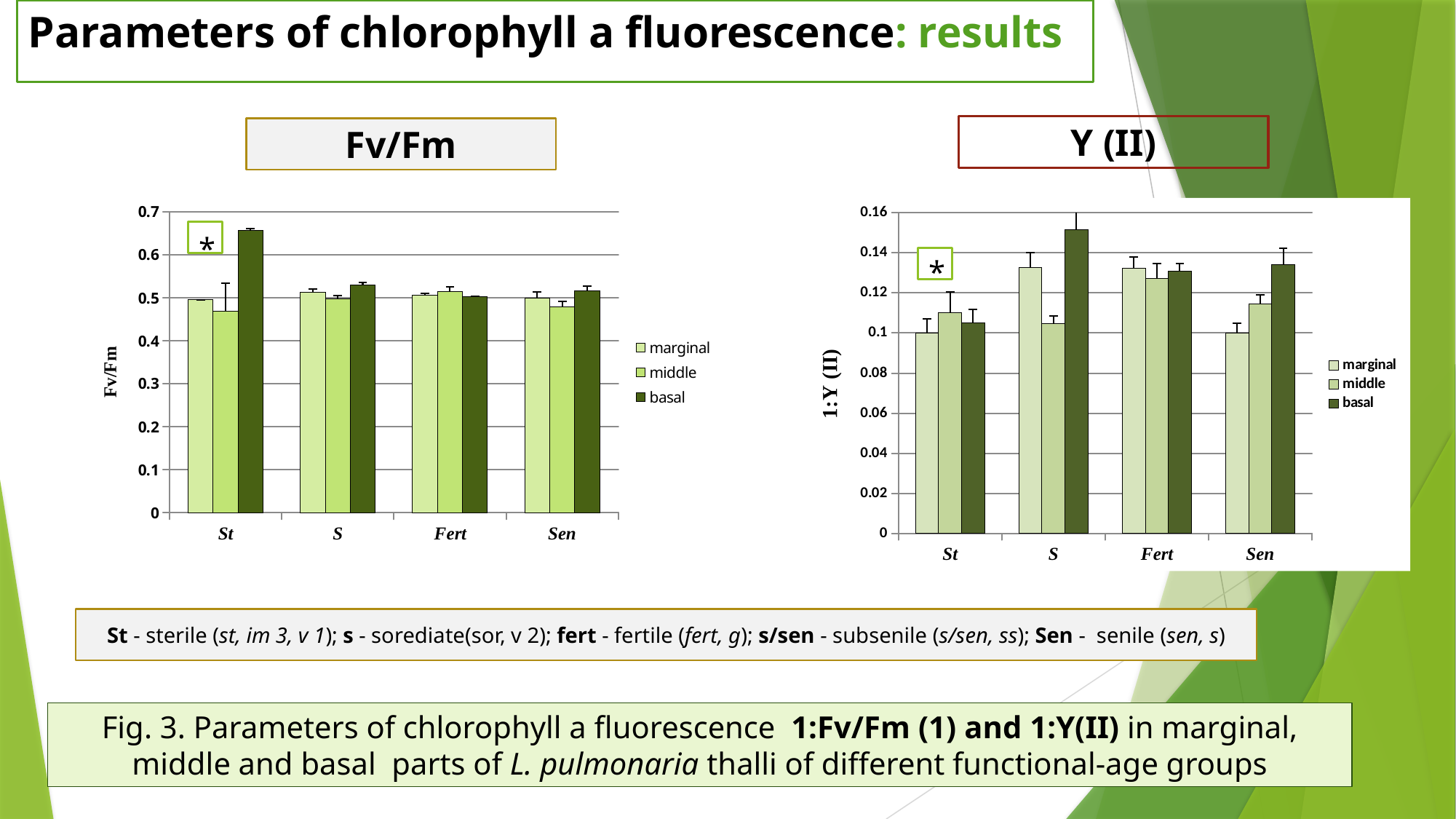
In the Y (II) chart, is the middle value for S greater or less than 0.12? less In the Y (II) chart, which is larger for S: the marginal value or the middle value? marginal What are the three legend entries of the Y (II) chart? marginal, middle, basal How many categories are shown on the x axis of the Y (II) chart on the right? 4 In the Fv/Fm chart, is the middle value for St greater or less than 0.5? less In the Fv/Fm chart, which category and series has the highest bar? St, basal How many series does the legend of the Fv/Fm chart list? 3 In the Fv/Fm chart, is the basal value for St greater or less than 0.6? greater What kind of chart is the Fv/Fm chart on the left? bar chart In the Y (II) chart, which category and series has the highest bar? S, basal In the Y (II) chart, which is larger: the basal value for St or the basal value for Sen? Sen